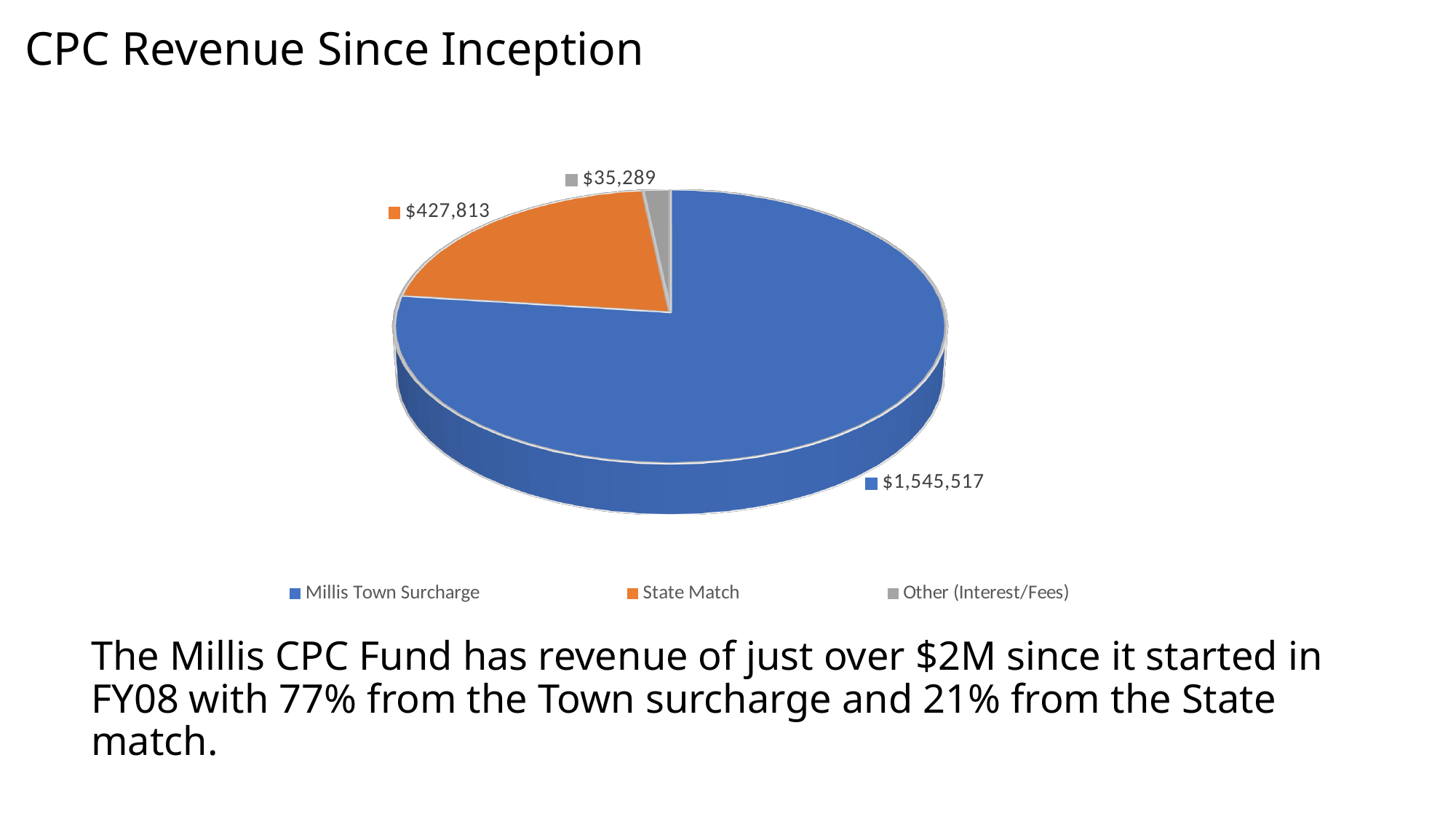
What is the revenue value for State Match? $427,813 Which revenue source has the smallest slice of the pie? Other (Interest/Fees) Which revenue source has the largest slice of the pie? Millis Town Surcharge How many slices does the pie chart have? 3 Which is larger, State Match or Other (Interest/Fees)? State Match What type of chart is shown on the slide? Pie chart What is the revenue value for Other (Interest/Fees)? $35,289 What is the title of the chart? CPC Revenue Since Inception What is the revenue value for Millis Town Surcharge? $1,545,517 What is the difference between the State Match value and the Other (Interest/Fees) value? $392,524 What is the difference between the Millis Town Surcharge value and the State Match value? $1,117,704